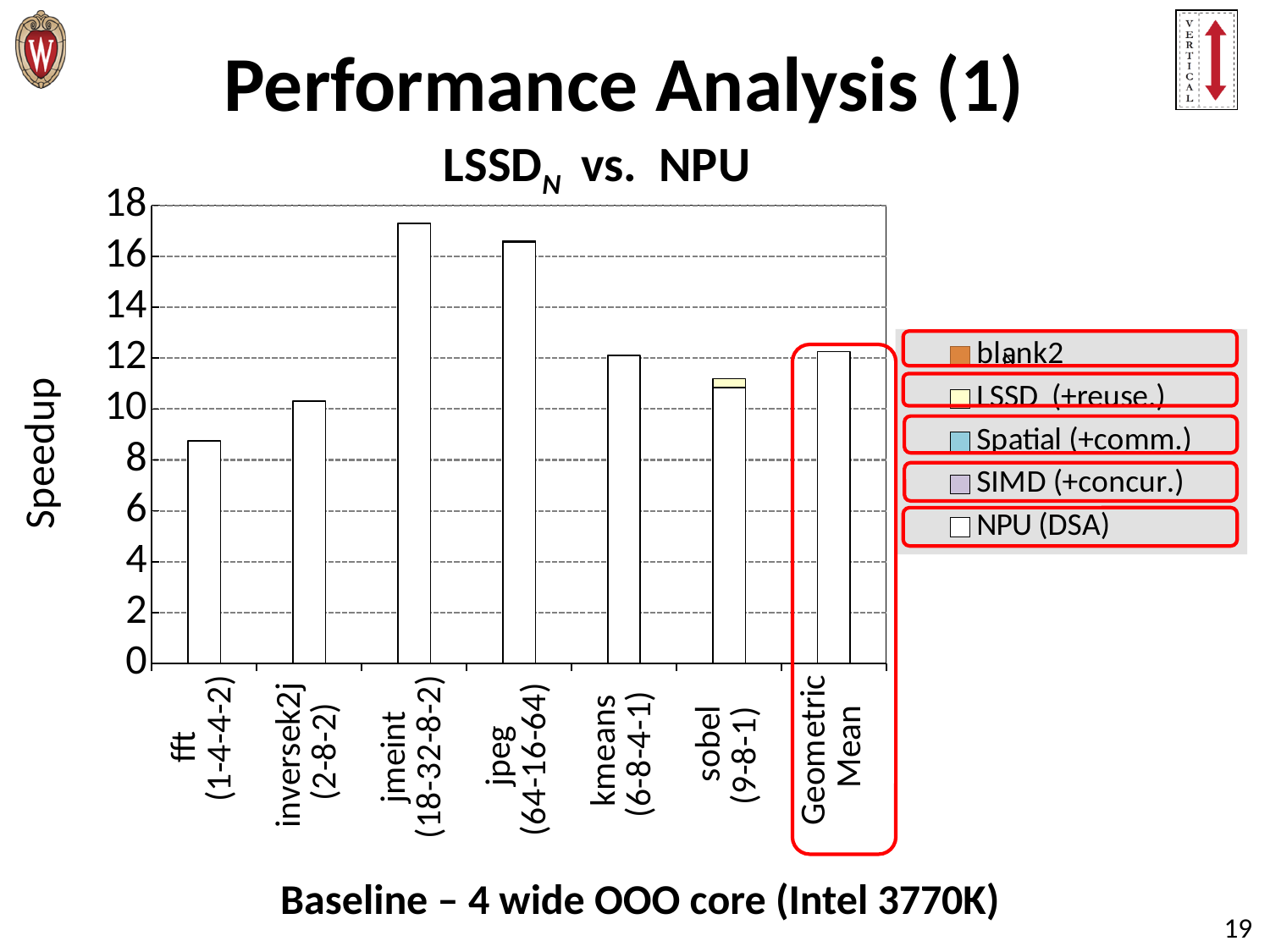
What is the label of the chart's vertical axis? Speedup Is the speedup for sobel (9-8-1) greater or less than 12? less Is the speedup for fft (1-4-4-2) greater or less than 10? less Which category has the highest speedup? jmeint (18-32-8-2) Which category has the lowest speedup? fft (1-4-4-2) How many series does the chart's legend list? 5 Which category on the x axis is highlighted with a red box? Geometric Mean Which has the larger speedup, fft (1-4-4-2) or inversek2j (2-8-2)? inversek2j (2-8-2) How many categories are shown on the x axis of the chart? 7 Is the speedup for jpeg (64-16-64) greater or less than 14? greater What kind of chart is shown on the slide? bar chart